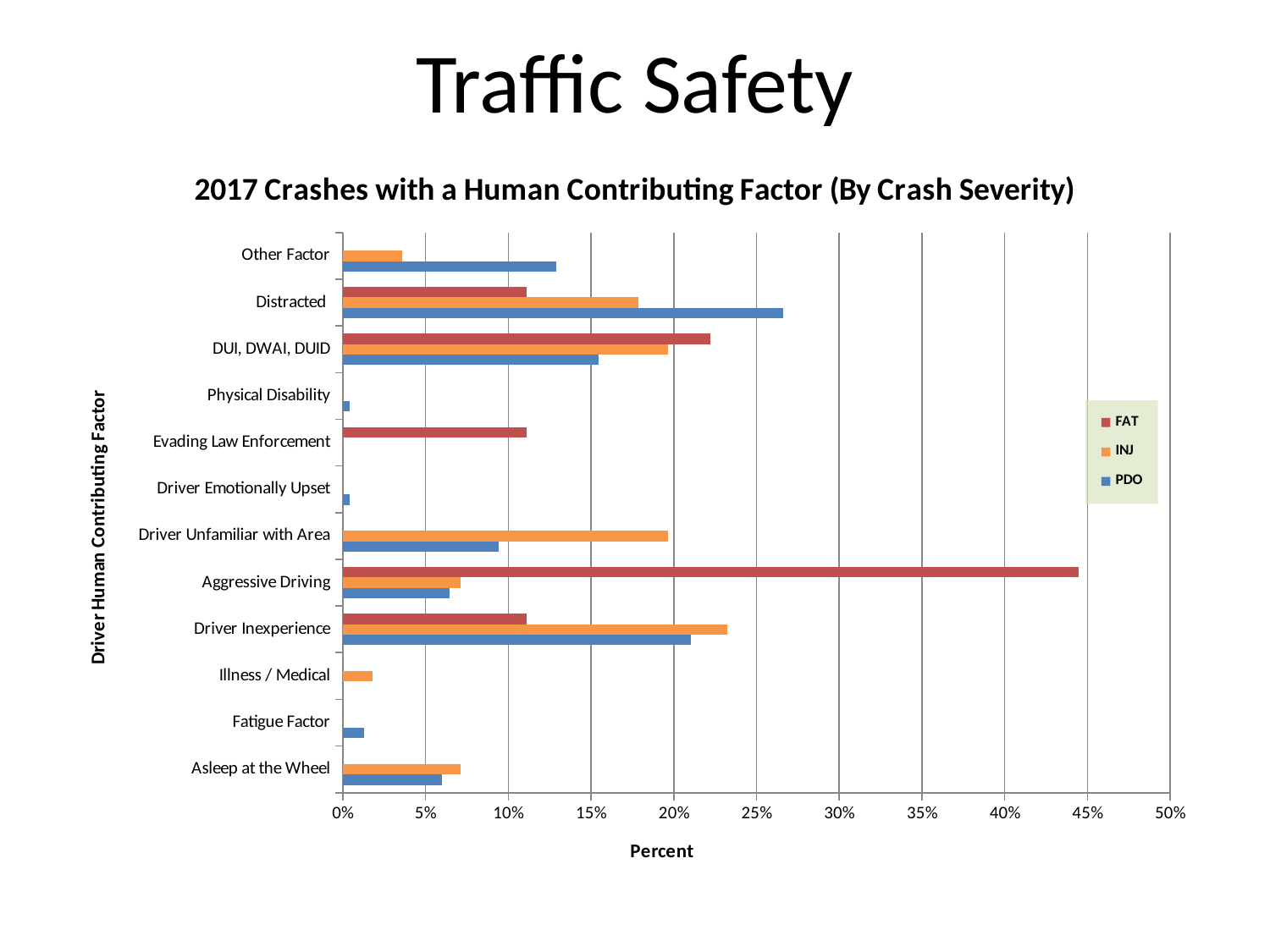
Is the PDO value for Distracted greater or less than 25%? greater For Distracted, which is larger: the PDO value or the INJ value? PDO What is the title of the chart? 2017 Crashes with a Human Contributing Factor (By Crash Severity) Which category has the highest FAT value? Aggressive Driving What kind of chart is shown on the slide? Bar chart Is the FAT value for Aggressive Driving greater or less than 40%? greater How many driver human contributing factor categories are shown on the chart? 12 How many series does the legend list? 3 Which category has the highest INJ value? Driver Inexperience Which category has the highest PDO value? Distracted Is the PDO value for Other Factor greater or less than 10%? greater